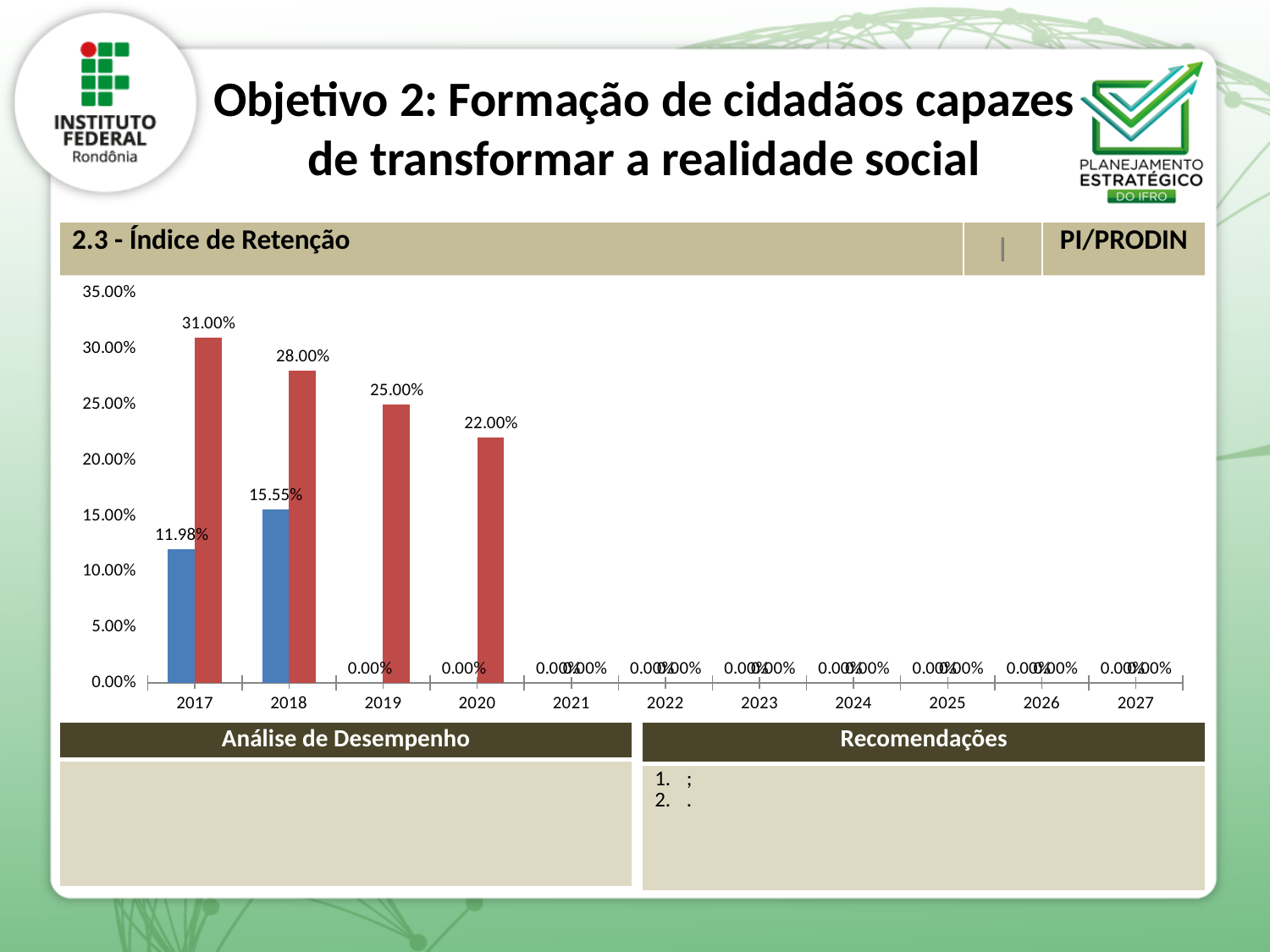
What is the value of the blue bar for 2018? 15.55% Do the red bar values rise or fall from 2017 to 2020? fall What is the title of the indicator shown above the chart? 2.3 - Índice de Retenção Which is larger, the blue bar for 2018 or the blue bar for 2017? 2018 What is the value of the red bar for 2020? 22.00% What is the value of the red bar for 2017? 31.00% Which year has the highest red bar? 2017 What is the value of the blue bar for 2017? 11.98% What is the difference between the red bar values for 2018 and 2019? 3.00% How many years are shown on the x axis? 11 What is the difference between the red bar and the blue bar for 2017? 19.02% What type of chart is shown on the slide? bar chart